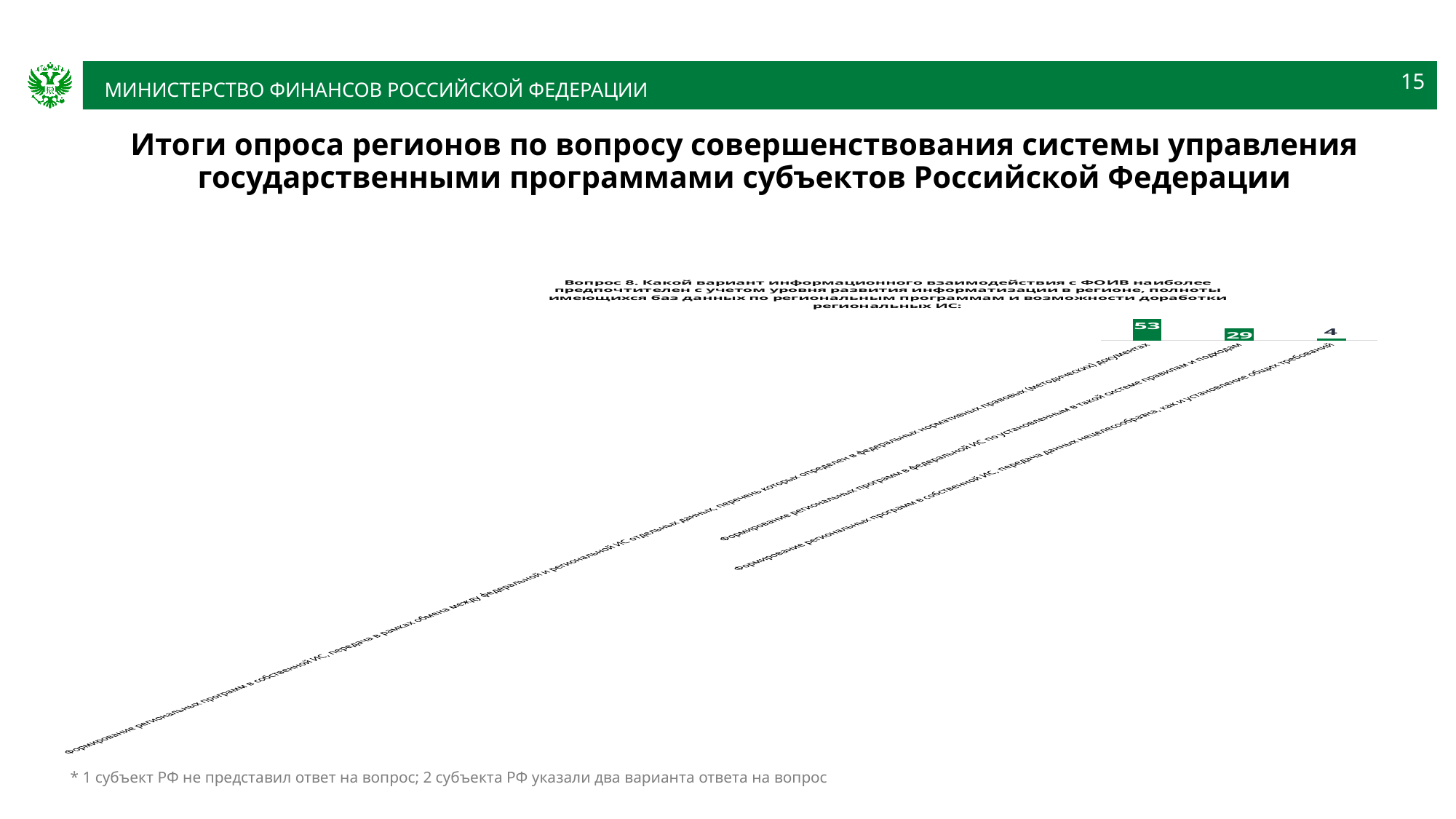
What is the value of the first (leftmost) bar, for forming regional programmes in the region's own IS with exchange of selected data between federal and regional IS? 53 What is the difference between the first bar (53) and the second bar (29)? 24 Which survey question number does the chart title refer to? Вопрос 8 How many bars (categories) does the chart show? 3 Which is larger: the value for forming programmes in the federal IS or the value for forming programmes in the region's own IS with no data transfer? forming programmes in the federal IS (29) What type of chart is shown on the slide? bar chart What is the value of the third (rightmost) bar, for forming regional programmes in the region's own IS with no data transfer? 4 What is the value of the second bar, for forming regional programmes in the federal IS according to its rules and approaches? 29 Which option received the lowest value? Формирование региональных программ в собственной ИС, передача данных нецелесообразна (4) Which option received the highest value? Формирование региональных программ в собственной ИС, передача в рамках обмена между федеральной и региональной ИС отдельных данных (53) Do the bar values rise or fall from left to right across the chart? fall What is the difference between the second bar (29) and the third bar (4)? 25